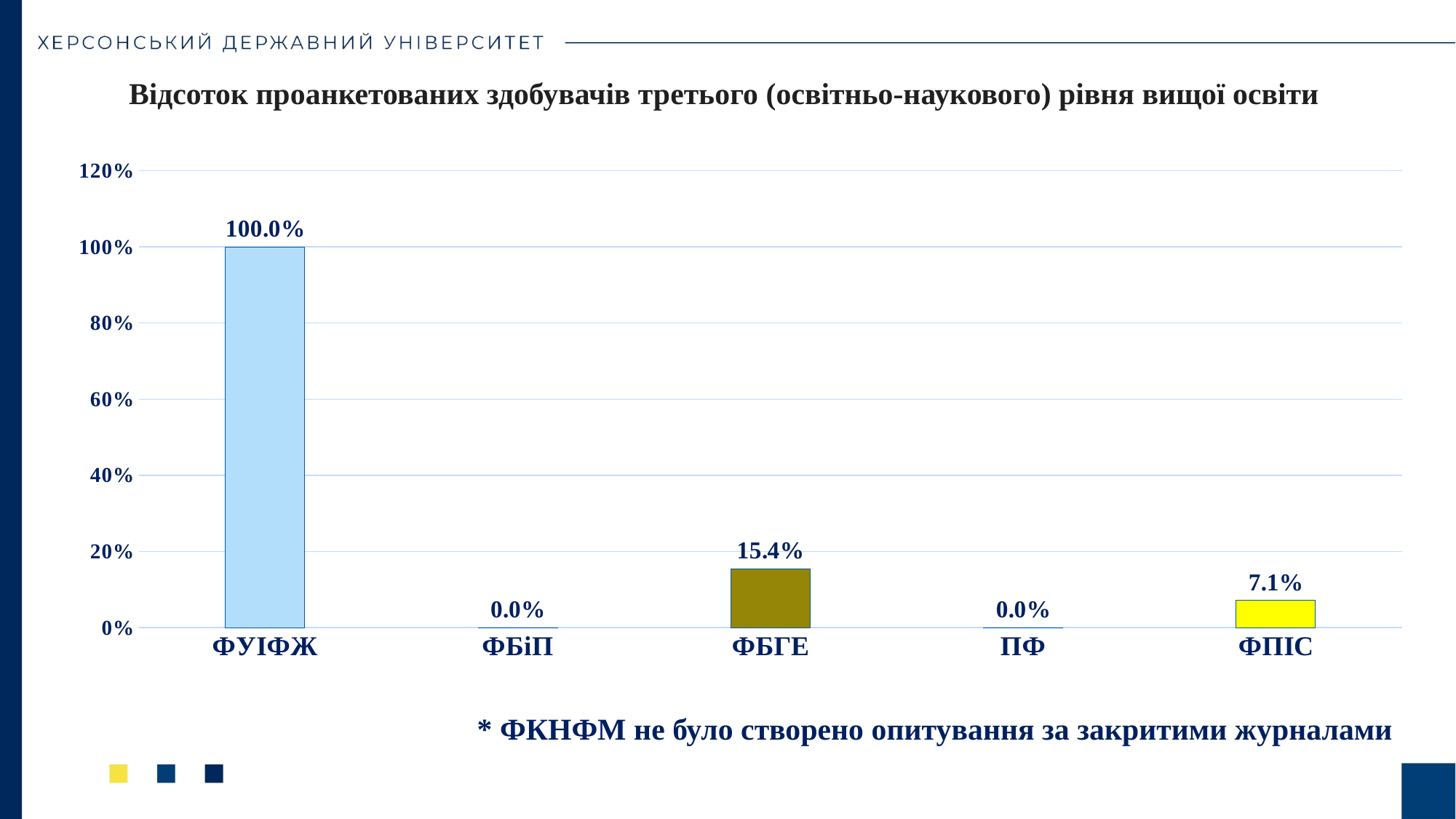
What kind of chart is shown on the slide? bar chart How many categories are shown on the x axis? 5 What is the difference between the values for ФБГЕ and ФПІС? 8.3% What is the difference between the values for ФУІФЖ and ФБГЕ? 84.6% What is the value for ФПІС? 7.1% What is the value for ФБГЕ? 15.4% What is the value for ФБіП? 0.0% Is the value for ФБГЕ greater or less than 20%? less What is the value for ФУІФЖ? 100.0% Which category has the highest value? ФУІФЖ How many categories have a value of 0.0%? 2 Which is larger, the value for ФБГЕ or the value for ФПІС? ФБГЕ